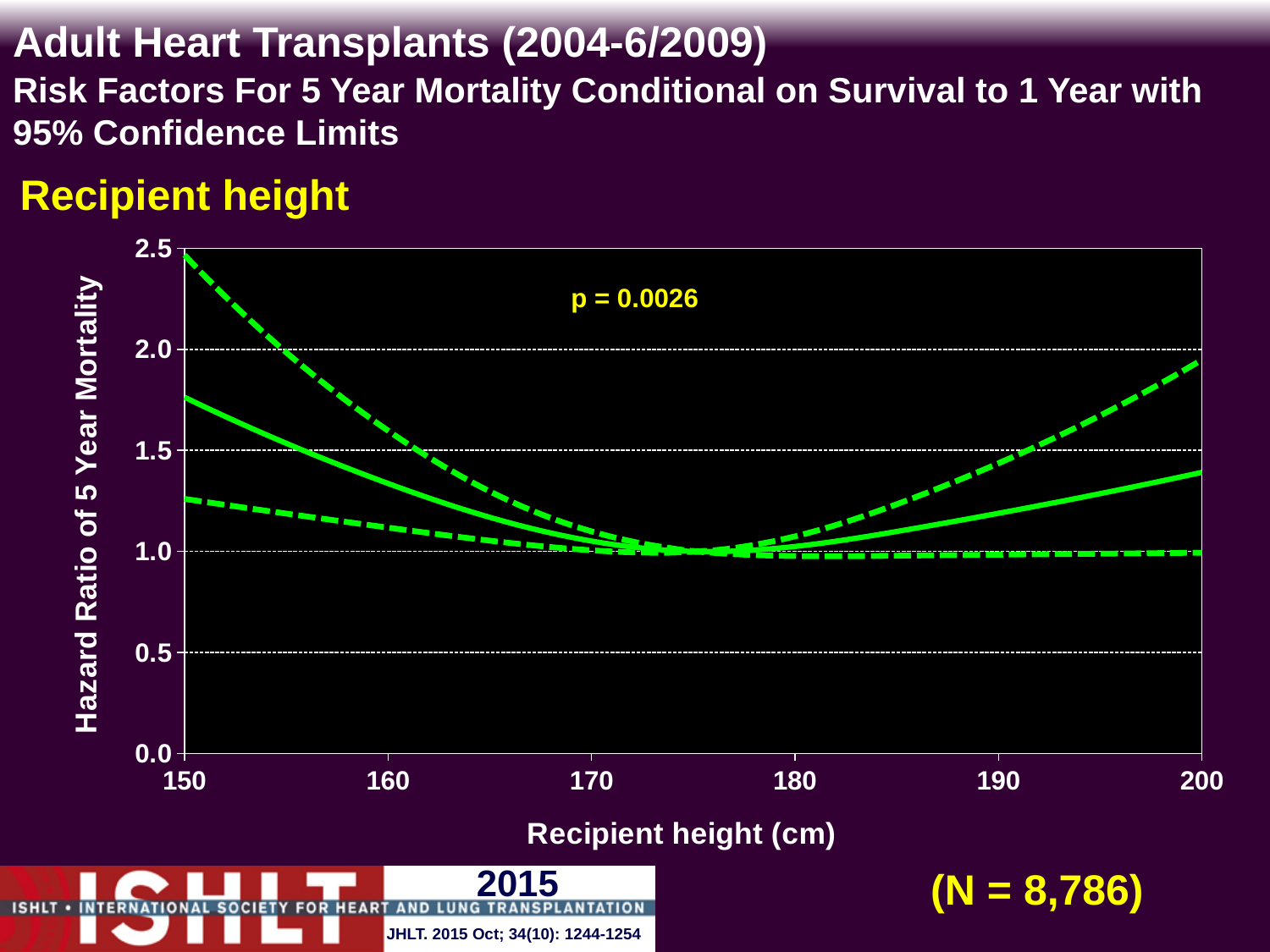
What is the sample size (N) shown on the slide? N = 8,786 Does the hazard ratio on the solid line rise or fall as recipient height increases from 180 cm to 200 cm? rise How many lines are plotted on the chart? 3 Is the hazard ratio on the solid line at a recipient height of 170 cm greater or less than 1.5? less On the solid line, is the hazard ratio larger at a recipient height of 150 cm or at 200 cm? 150 cm Is the upper confidence limit (upper dashed line) at a recipient height of 150 cm greater or less than 2.0? greater What kind of chart is shown on the slide? line chart Is the hazard ratio on the solid line at a recipient height of 150 cm greater or less than 1.5? greater What p-value is shown on the chart? p = 0.0026 Does the hazard ratio on the solid line rise or fall as recipient height increases from 150 cm to 170 cm? fall